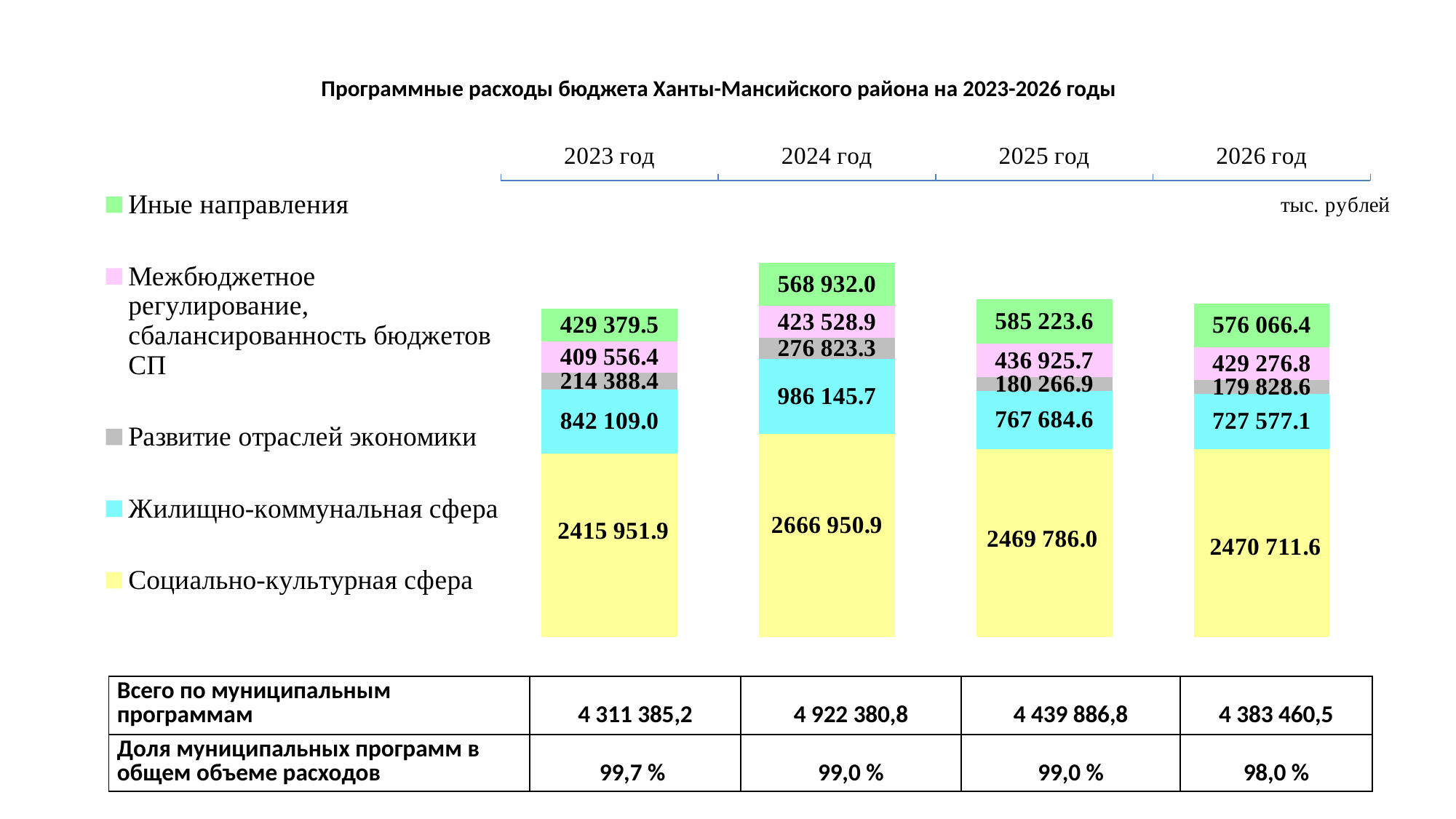
What is the difference between the Жилищно-коммунальная сфера values for 2024 год and 2023 год? 144 036.7 Which is larger: Иные направления in 2025 год or in 2026 год? 2025 год What is the value for Развитие отраслей экономики in 2025 год? 180 266.9 What kind of chart is shown on the slide? Stacked bar chart What is the value for Межбюджетное регулирование, сбалансированность бюджетов СП in 2026 год? 429 276.8 In which year is the value for Жилищно-коммунальная сфера the lowest? 2026 год What is the value for Жилищно-коммунальная сфера in 2023 год? 842 109.0 What is the total of the stacked bar for 2023 год? 4 311 385,2 How many years are shown on the x axis of the chart? 4 How many series does the legend list? 5 In which year is the value for Социально-культурная сфера the highest? 2024 год What is the value for Иные направления in 2024 год? 568 932.0